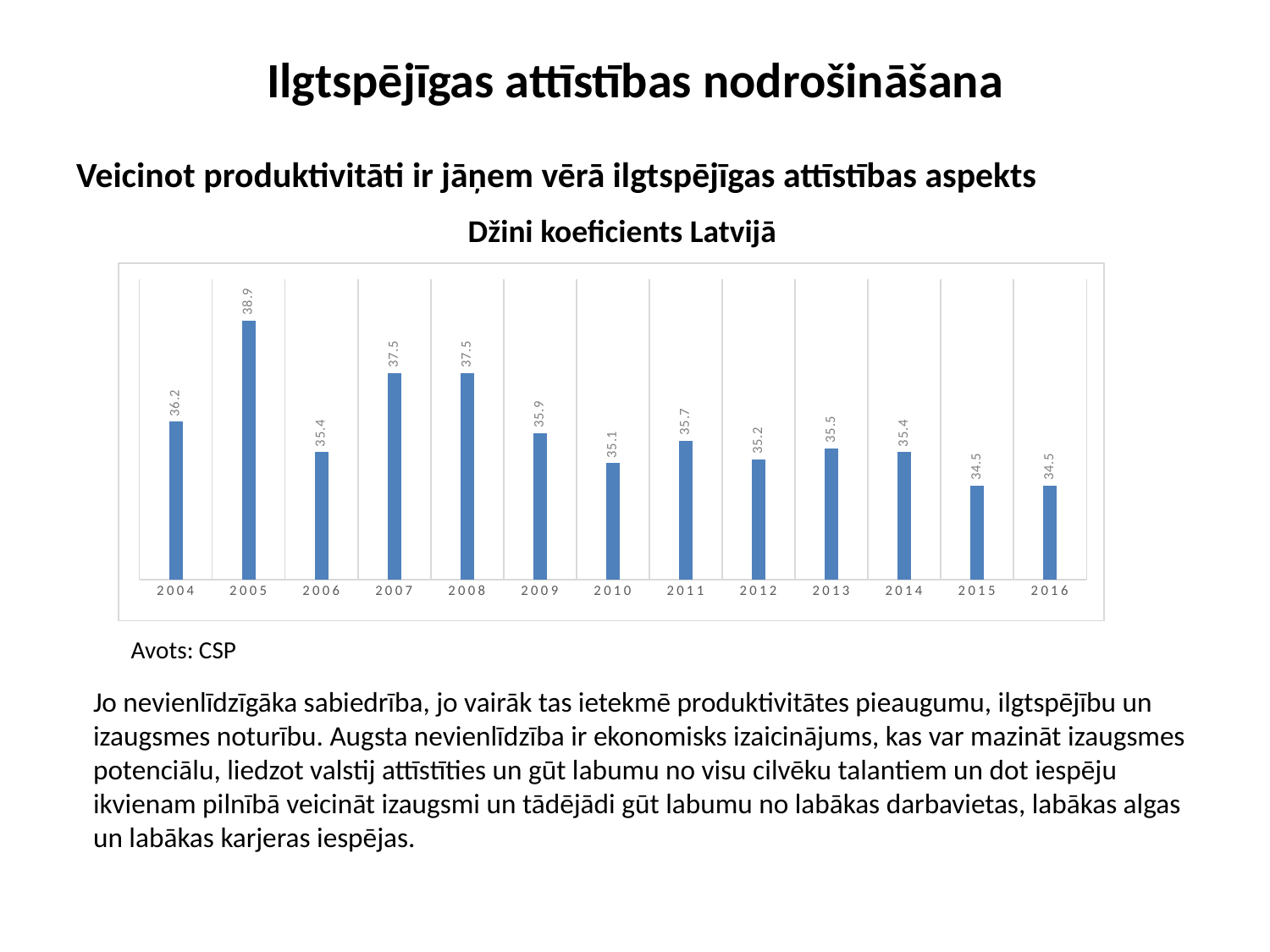
What is the Gini coefficient value shown for 2005? 38.9 What is the difference between the values for 2008 and 2009? 1.6 What is the difference between the values for 2005 and 2004? 2.7 What value is shown for 2016? 34.5 What kind of chart is shown on the slide? Bar chart Which year has the larger value, 2011 or 2012? 2011 Which year has the highest value in the chart? 2005 What is the lowest value shown in the chart? 34.5 What value is shown for 2010? 35.1 How many years are shown on the x axis of the chart? 13 Which year has the larger value, 2007 or 2009? 2007 Do the values rise or fall from 2013 to 2016? Fall